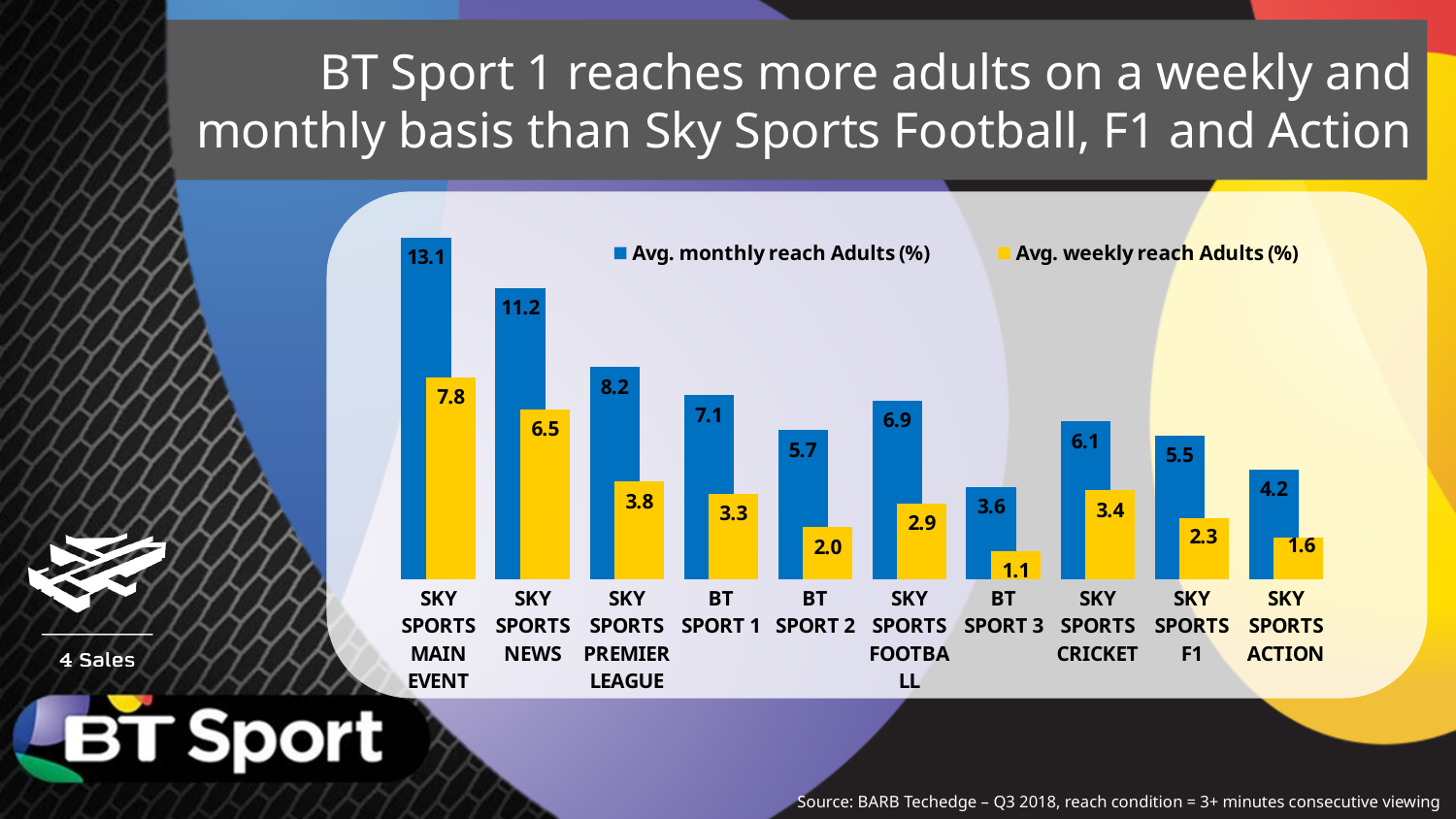
What is the average monthly reach of adults (%) for BT Sport 1? 7.1 What is the average monthly reach of adults (%) for Sky Sports Action? 4.2 Which has a higher average monthly reach of adults, BT Sport 1 or Sky Sports Football? BT Sport 1 Which channel has the highest average monthly reach of adults? Sky Sports Main Event Which series is shown in yellow in the chart? Avg. weekly reach Adults (%) What type of chart is shown on the slide? Bar chart Which channel has the lowest average weekly reach of adults? BT Sport 3 What is the difference in average weekly reach of adults between BT Sport 1 and Sky Sports F1? 1.0 How many series does the legend list? 2 What is the average weekly reach of adults (%) for Sky Sports Cricket? 3.4 How many channels are shown on the chart? 10 What is the difference between the average monthly reach and the average weekly reach of adults for Sky Sports News? 4.7